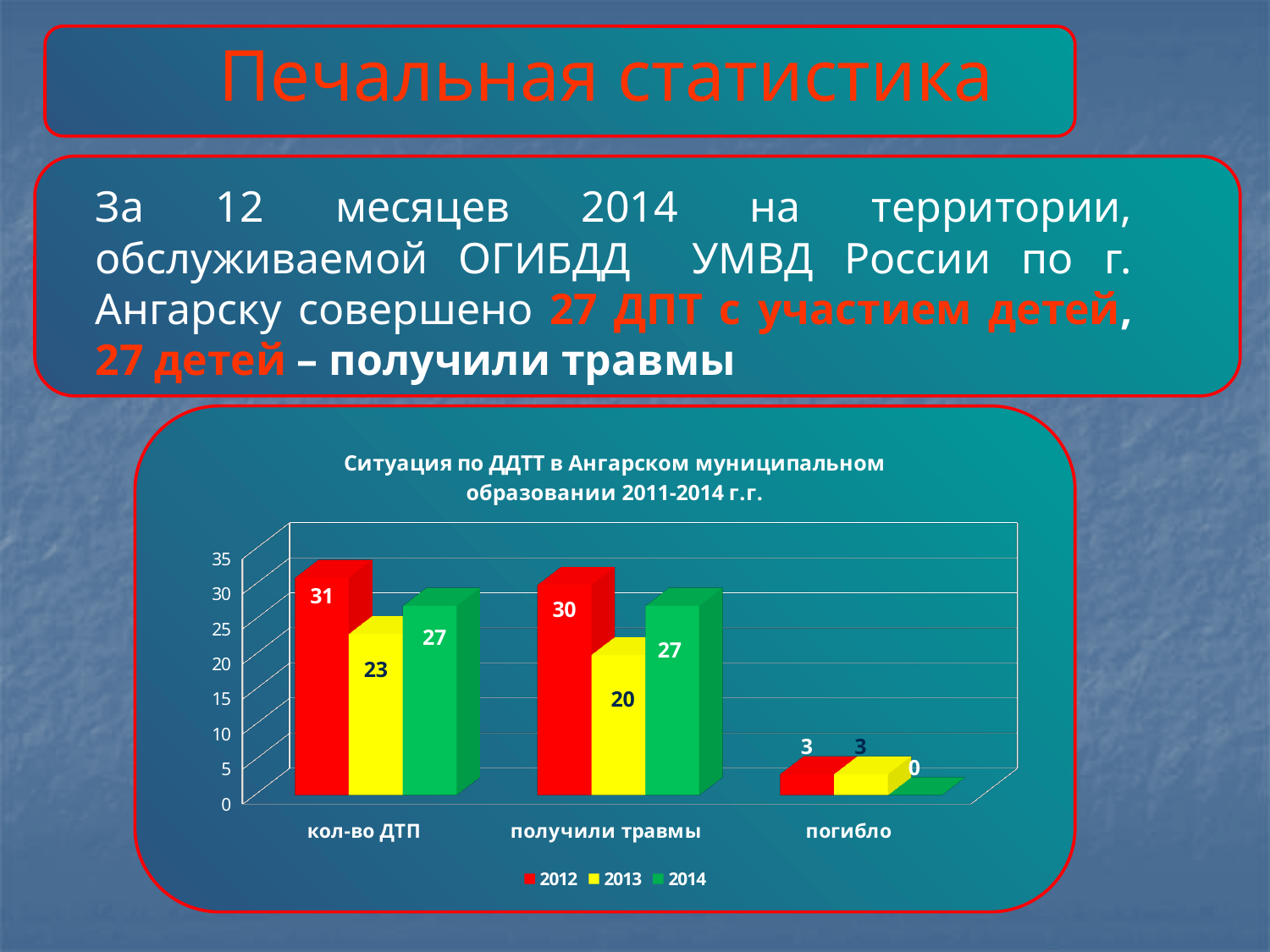
Which colour represents the 2013 series in the chart? yellow What is the value for 2013 in the получили травмы category? 20 What kind of chart is shown on the slide? bar chart Which is larger: the 2014 value for кол-во ДТП or the 2013 value for кол-во ДТП? 2014 Which year has the highest value in the кол-во ДТП category? 2012 What is the value for 2014 in the погибло category? 0 How many series does the legend list? 3 What is the title of the chart? Ситуация по ДДТТ в Ангарском муниципальном образовании 2011-2014 г.г. How many categories are shown on the x axis? 3 What is the value for 2012 in the кол-во ДТП category? 31 What is the difference between the 2012 and 2013 values in the кол-во ДТП category? 8 Which year has the lowest value in the получили травмы category? 2013